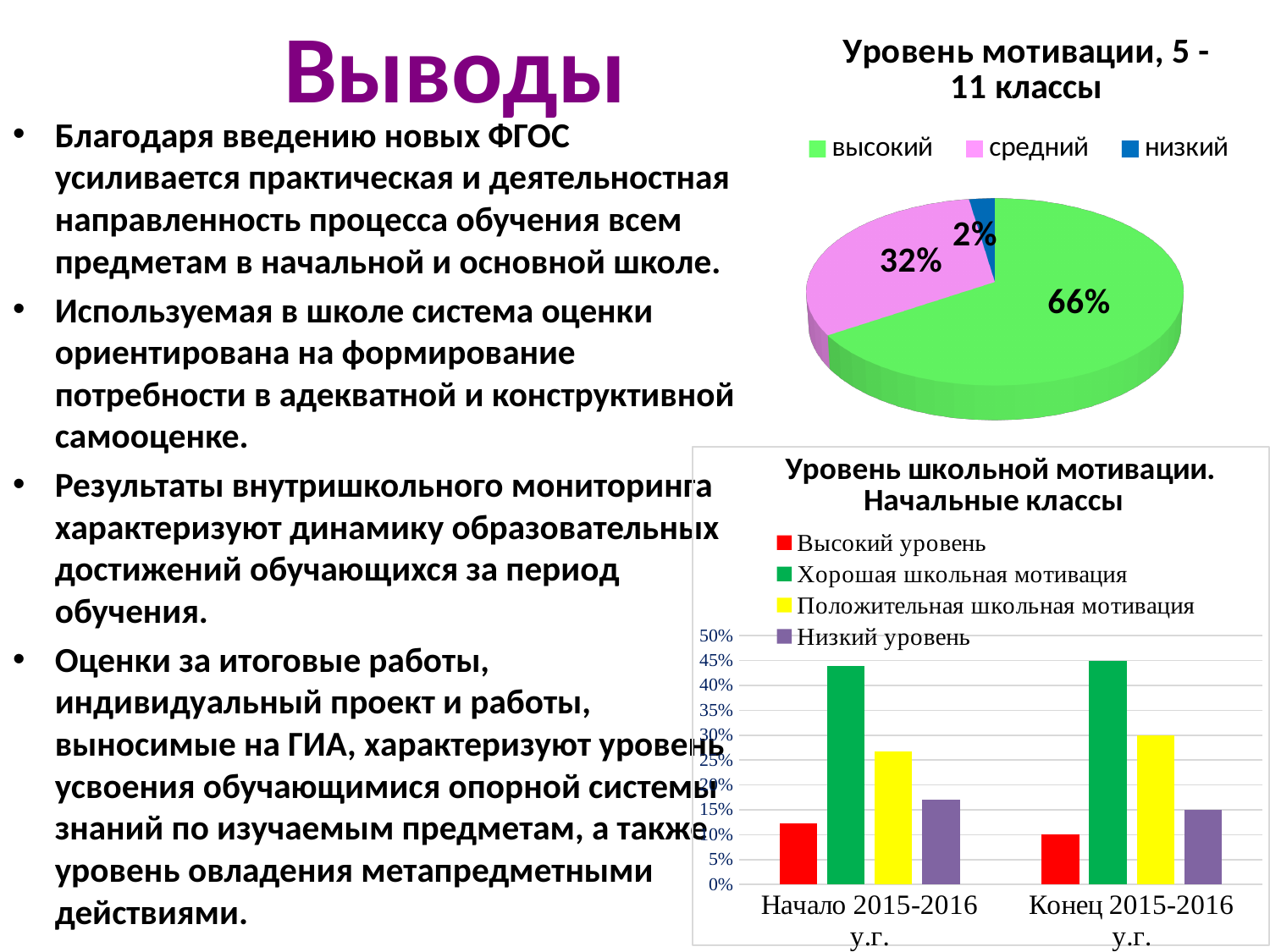
In the pie chart 'Уровень мотивации, 5 - 11 классы', what share is labelled for 'высокий'? 66% How many series does the legend of the chart 'Уровень школьной мотивации. Начальные классы' list? 4 In the pie chart 'Уровень мотивации, 5 - 11 классы', which category has the largest slice? высокий In the pie chart 'Уровень мотивации, 5 - 11 классы', what share is labelled for 'средний'? 32% In the chart 'Уровень школьной мотивации. Начальные классы', which series has the tallest bar at 'Конец 2015-2016 у.г.'? Хорошая школьная мотивация How many categories does the legend of the pie chart 'Уровень мотивации, 5 - 11 классы' list? 3 In the pie chart 'Уровень мотивации, 5 - 11 классы', which category has the smallest slice? низкий What type of chart is 'Уровень школьной мотивации. Начальные классы'? bar chart In the pie chart 'Уровень мотивации, 5 - 11 классы', what is the difference between the 'высокий' and 'средний' shares? 34% In the pie chart 'Уровень мотивации, 5 - 11 классы', what share is labelled for 'низкий'? 2% In the chart 'Уровень школьной мотивации. Начальные классы', is the value for 'Высокий уровень' at 'Конец 2015-2016 у.г.' greater or less than 15%? less In the chart 'Уровень школьной мотивации. Начальные классы', is the value for 'Хорошая школьная мотивация' at 'Начало 2015-2016 у.г.' greater or less than 40%? greater